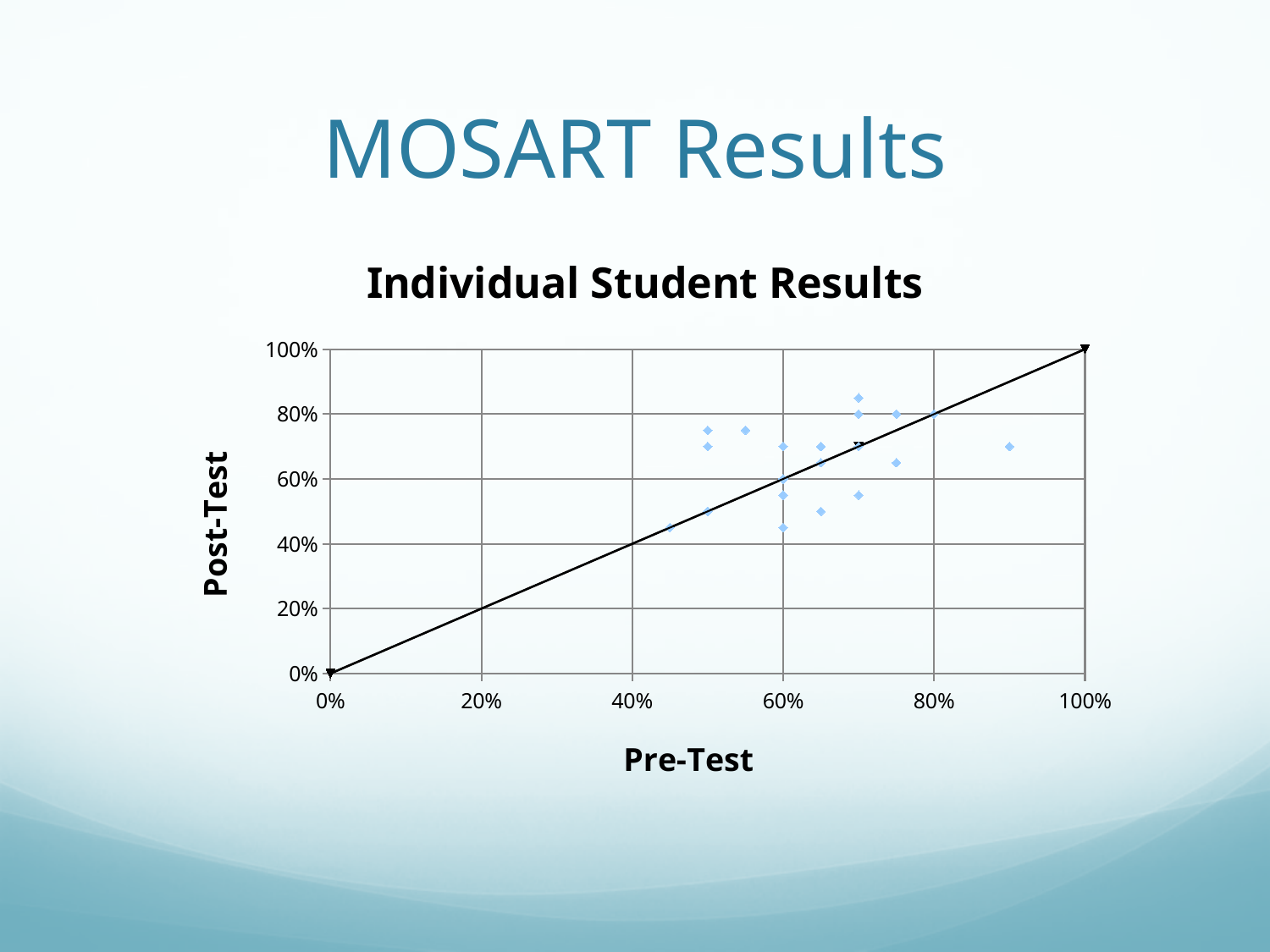
Is the post-test value of the lowest point on the chart greater or less than 40%? greater What are the titles of the x axis and y axis of the chart? Pre-Test (x axis) and Post-Test (y axis) What kind of chart is shown on the slide? Scatter chart Is the pre-test value of the leftmost point on the chart greater or less than 40%? greater What is the title of the chart? Individual Student Results Does the diagonal line on the chart rise or fall as the pre-test value increases? Rise Is the post-test value of the highest point on the chart greater or less than 80%? greater